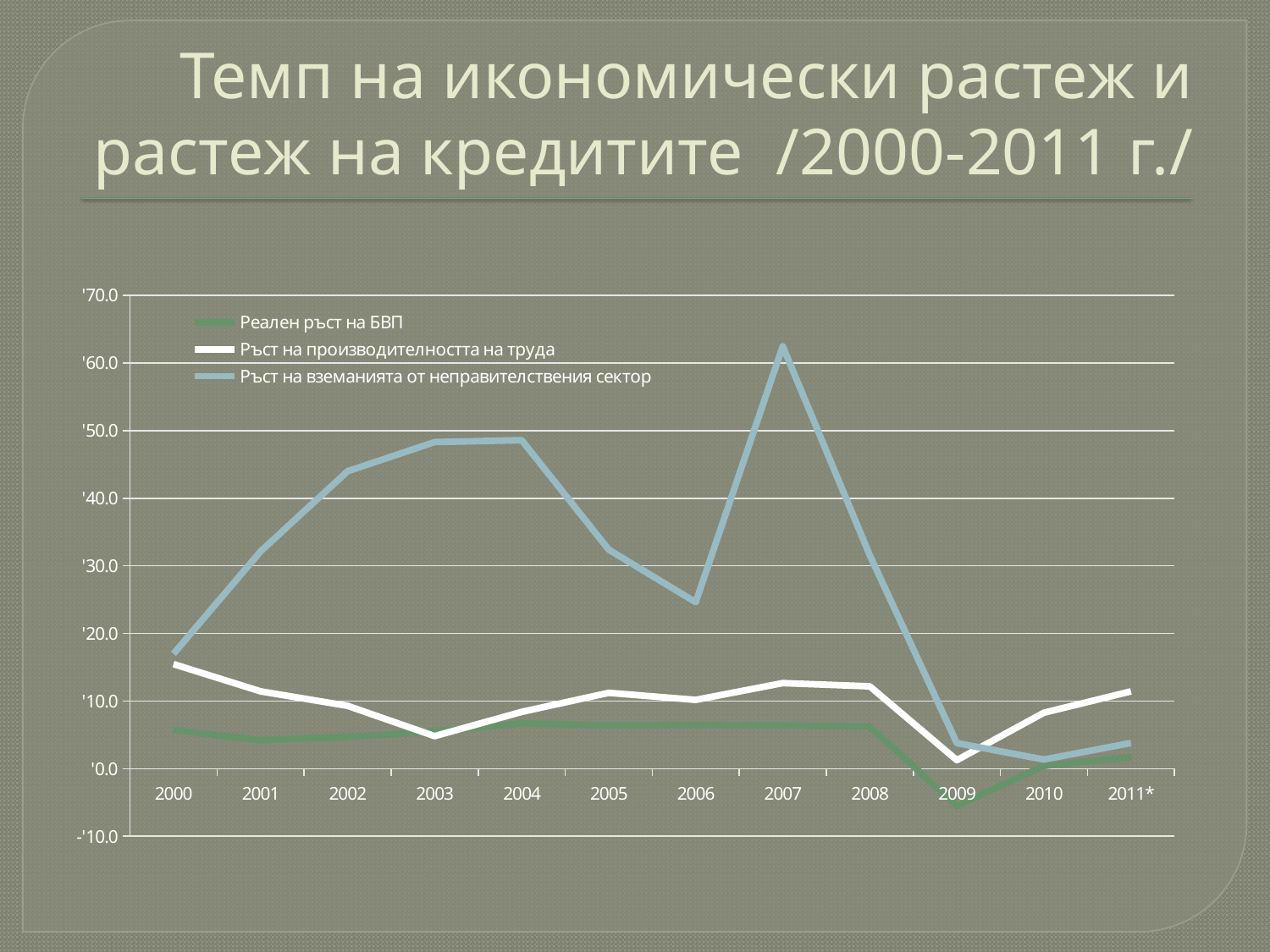
How many series does the legend list? 3 Is the value for 'Ръст на производителността на труда' in 2000 greater or less than 10.0? greater How many years are plotted along the x axis? 12 In which year does the series 'Реален ръст на БВП' reach its lowest value? 2009 Is the value for 'Ръст на вземанията от неправителствения сектор' in 2007 greater or less than 60.0? greater Does the series 'Ръст на вземанията от неправителствения сектор' rise or fall from 2007 to 2009? fall Is the value for 'Реален ръст на БВП' in 2009 greater or less than 0.0? less In which year does the series 'Ръст на вземанията от неправителствения сектор' reach its highest value? 2007 Which is larger for 'Ръст на вземанията от неправителствения сектор': the value in 2004 or the value in 2007? 2007 What kind of chart is shown on the slide? line chart What is the title of the chart on the slide? Темп на икономически растеж и растеж на кредитите /2000-2011 г./